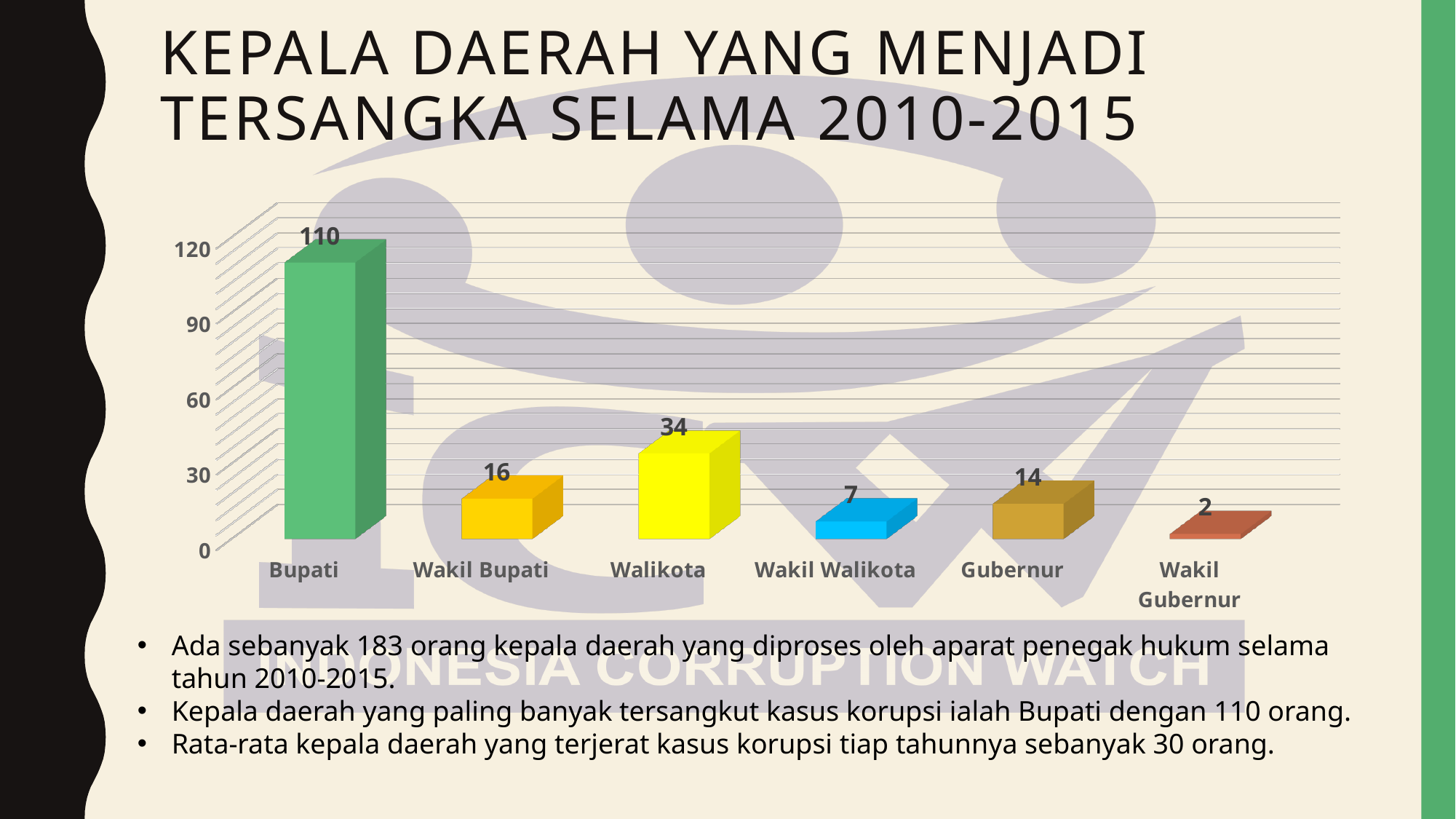
Which category has the lowest value? Wakil Gubernur What is the value for Gubernur? 14 What colour is the bar for Walikota? yellow How many categories are shown on the x axis? 6 What is the value for Wakil Walikota? 7 What kind of chart is shown on the slide? bar chart Which category has the highest value? Bupati What is the value for Walikota? 34 What is the difference between the values for Bupati and Walikota? 76 What is the difference between the values for Wakil Bupati and Gubernur? 2 What is the value for Bupati? 110 Which is larger, the value for Wakil Bupati or the value for Wakil Walikota? Wakil Bupati